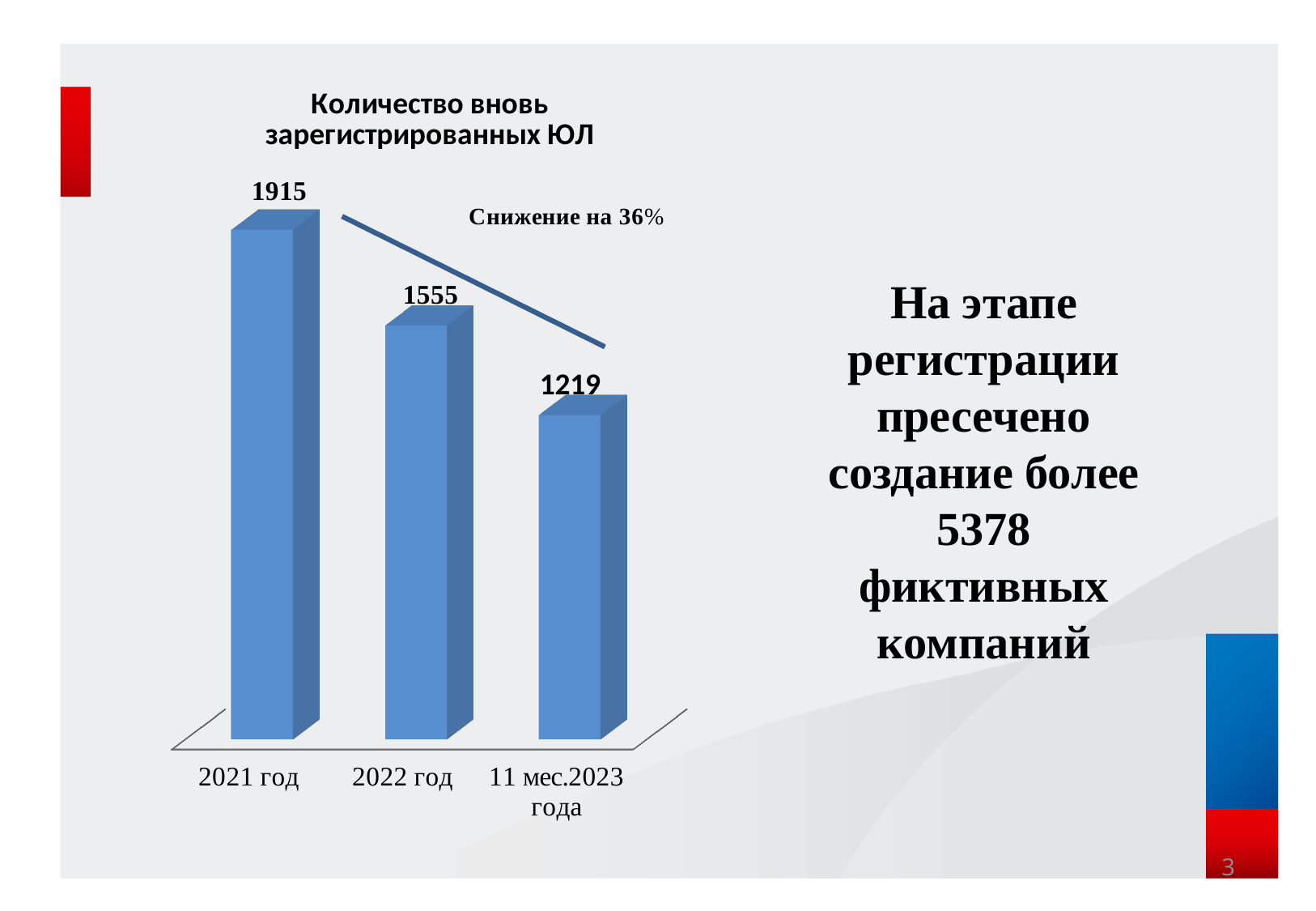
What is the difference between the values for 2022 год and 11 мес.2023 года? 336 What is the value for 2022 год? 1555 Which category has the lowest value? 11 мес.2023 года What is the value for 2021 год? 1915 What is the difference between the values for 2021 год and 2022 год? 360 What kind of chart is shown on the slide? bar chart Which is larger, the value for 2021 год or the value for 11 мес.2023 года? 2021 год How many categories are shown on the chart? 3 Which category has the highest value? 2021 год What is the value for 11 мес.2023 года? 1219 Do the values rise or fall from 2021 год to 11 мес.2023 года? fall What is the title of the chart? Количество вновь зарегистрированных ЮЛ